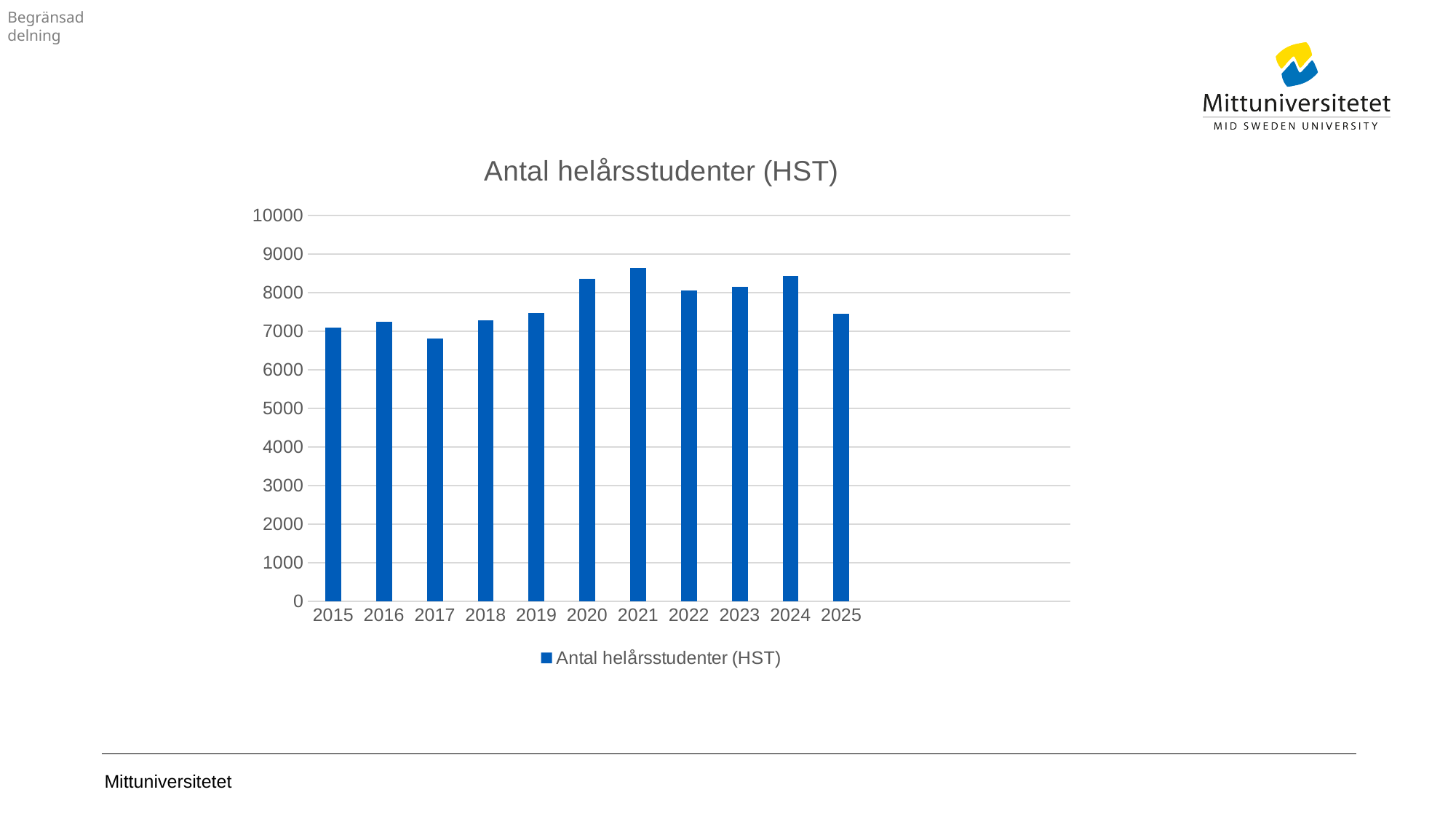
How many years are shown on the x axis of the chart? 11 How many series does the legend list? 1 Is the value for 2025 greater or less than 8000? less Which year has the larger value, 2024 or 2025? 2024 Is the value for 2024 greater or less than 8000? greater Is the value for 2020 greater or less than 8000? greater Which year has the highest number of helårsstudenter (HST)? 2021 Which year has the lowest number of helårsstudenter (HST)? 2017 What kind of chart is shown on the slide? bar chart Do the values rise or fall from 2017 to 2021? rise What is the title of the chart? Antal helårsstudenter (HST)